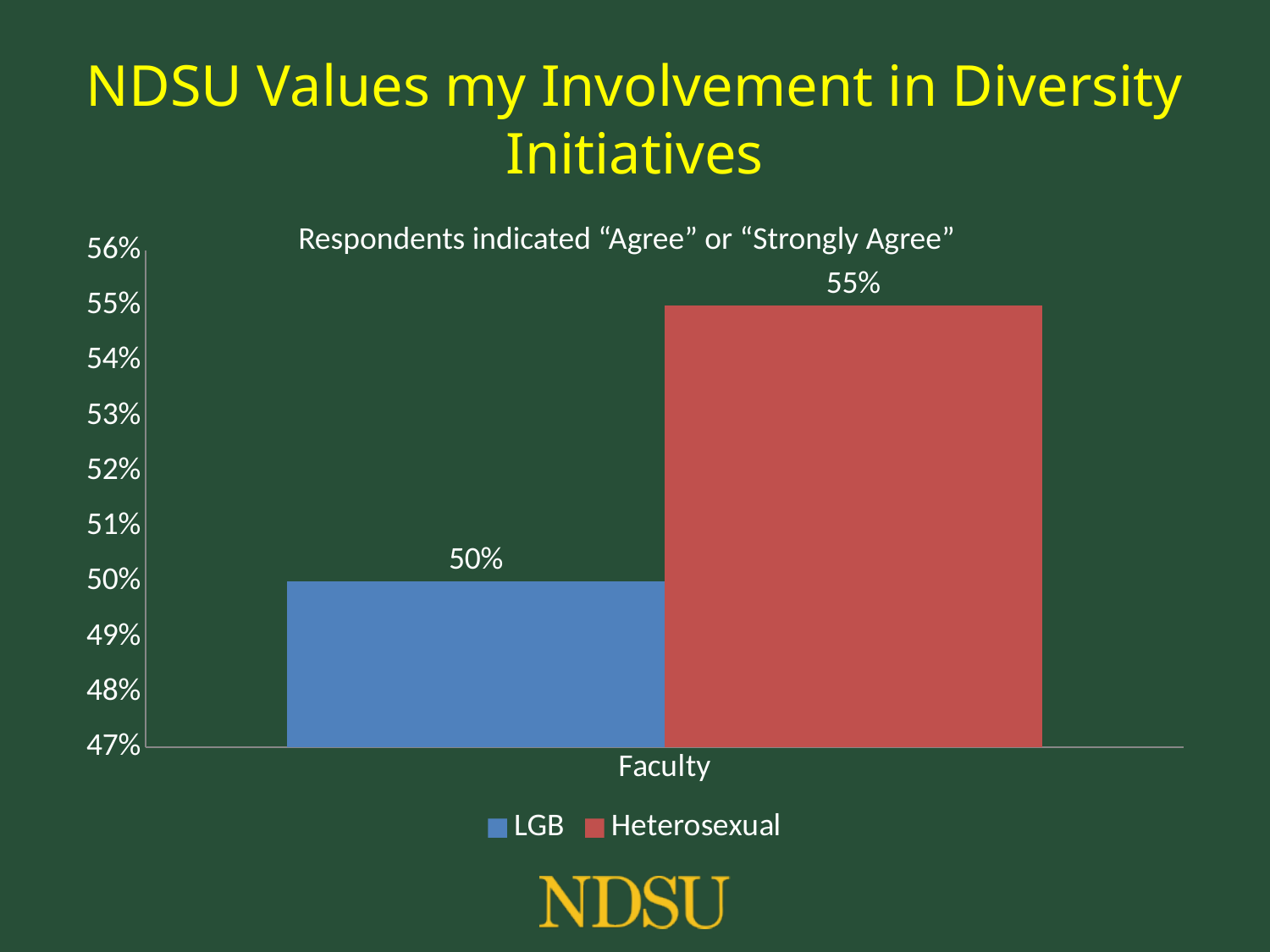
Is the value for LGB larger or smaller than the value for Heterosexual? smaller What kind of chart is shown on the slide? bar chart Which series has the higher value for Faculty? Heterosexual Which series has the lower value for Faculty? LGB What is the difference between the Heterosexual and LGB values? 5% How many categories are shown on the x axis? 1 How many series does the legend list? 2 What colour is the bar for the Heterosexual series? red What is the value for Heterosexual faculty? 55% What is the value for LGB faculty? 50% What is the chart's title? Respondents indicated "Agree" or "Strongly Agree" Is the value for Heterosexual greater or less than 52%? greater